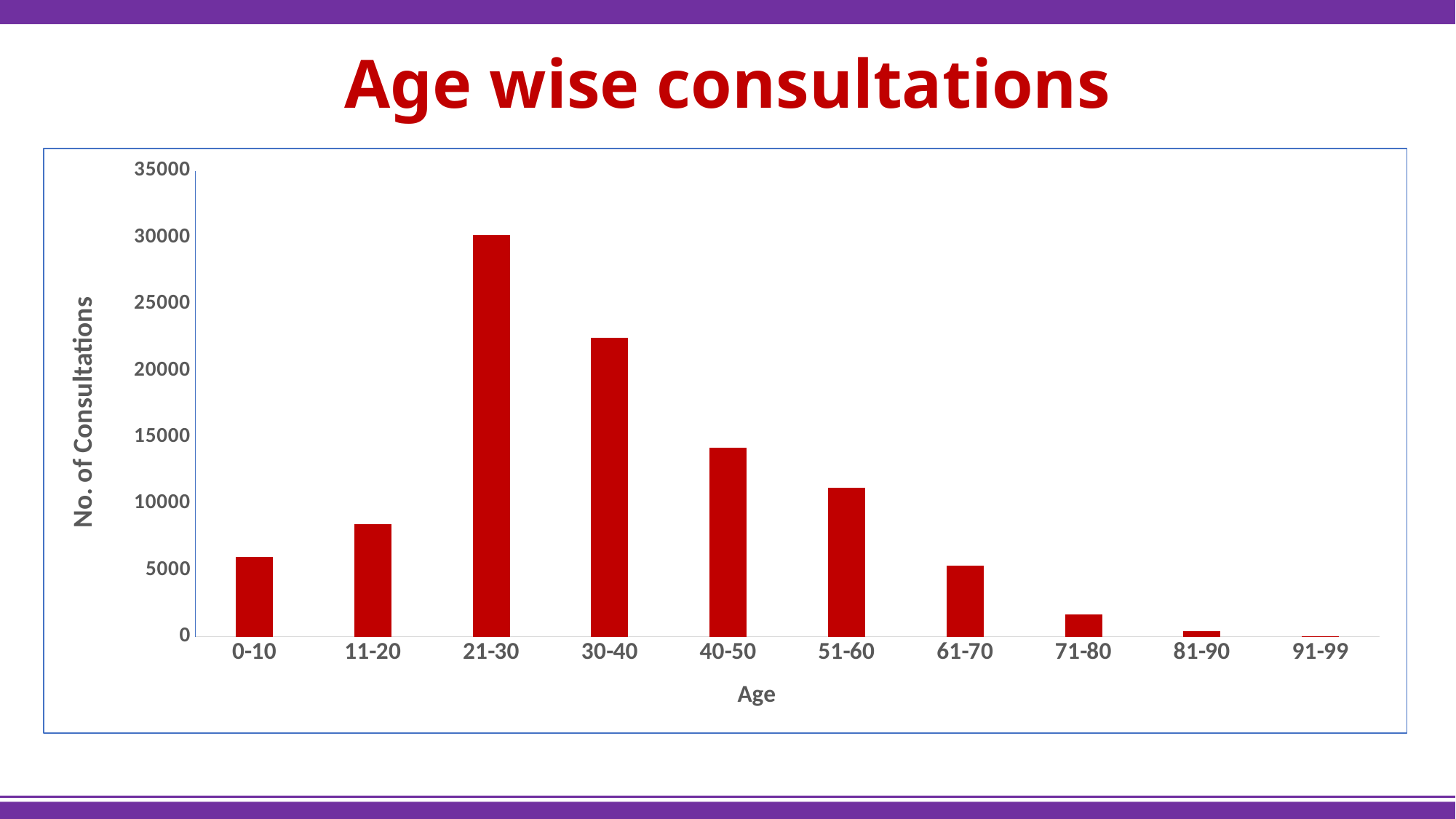
What kind of chart is shown on the slide? bar chart Is the value for the 30-40 age group greater or less than 20000? greater Is the value for the 11-20 age group greater or less than 10000? less Which age group has the lowest number of consultations? 91-99 Do the values rise or fall along the x axis from the 21-30 group to the 91-99 group? fall Is the value for the 0-10 age group greater or less than 5000? greater Which age group has more consultations, 30-40 or 40-50? 30-40 What is the title of the vertical axis? No. of Consultations How many age categories are shown on the x axis? 10 Which age group has the highest number of consultations? 21-30